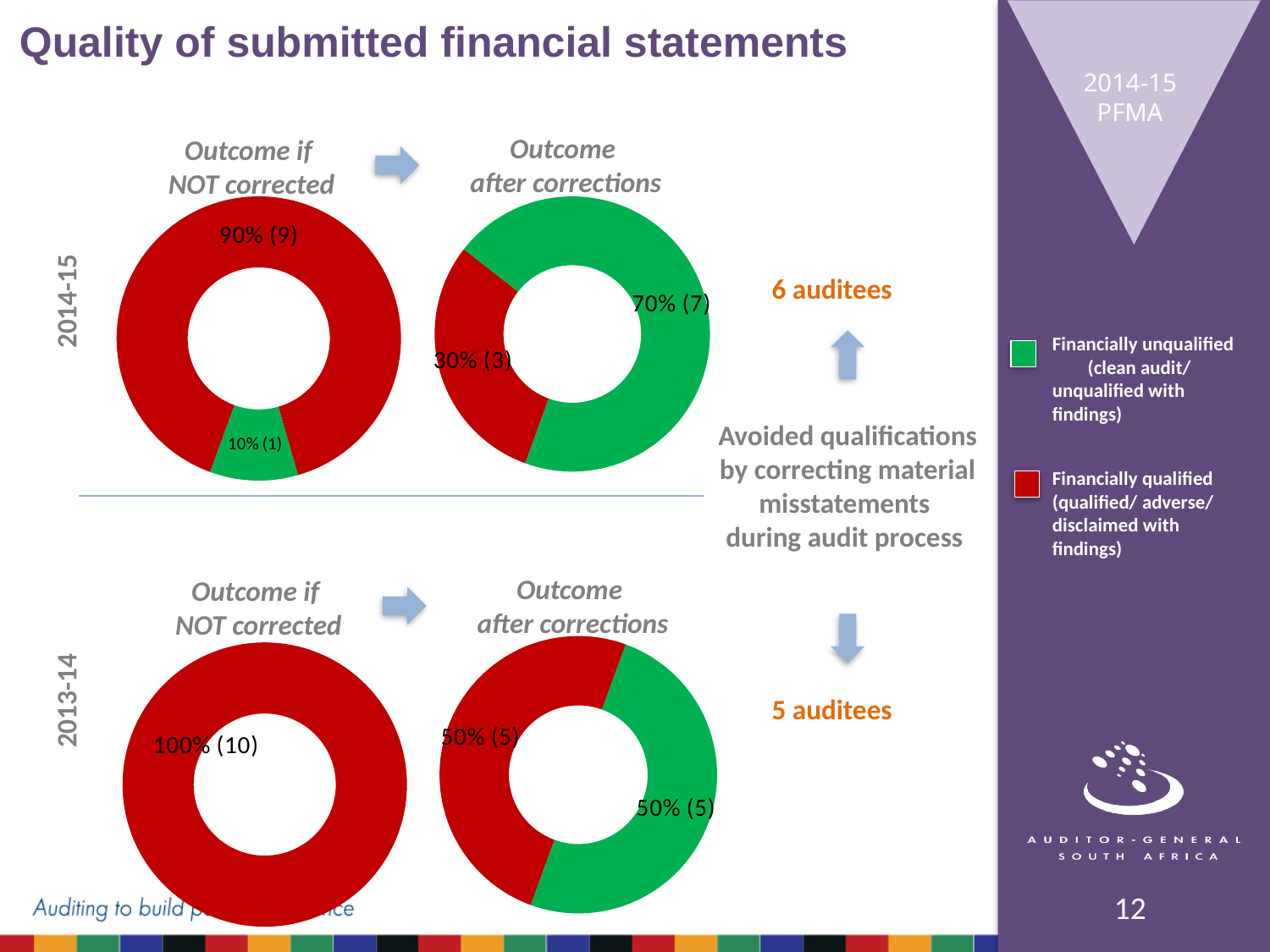
How many segments does the 2013-14 'Outcome if NOT corrected' chart have? 1 According to the legend, what does the green colour represent? Financially unqualified (clean audit/ unqualified with findings) In the 2014-15 'Outcome after corrections' chart, which segment is larger, financially unqualified or financially qualified? Financially unqualified In the 2013-14 'Outcome if NOT corrected' chart, what share is financially qualified (red)? 100% (10) In the 2014-15 'Outcome after corrections' chart, what share is financially qualified (red)? 30% (3) In the 2014-15 'Outcome after corrections' chart, what is the difference in percentage points between the financially unqualified and financially qualified segments? 40 percentage points What type of chart is used to show the outcomes on this slide? Doughnut (pie) chart In the 2014-15 'Outcome after corrections' chart, what share is financially unqualified (green)? 70% (7) In the 2014-15 'Outcome if NOT corrected' chart, what share is financially unqualified (green)? 10% (1) In the 2014-15 'Outcome if NOT corrected' chart, which segment is the smallest? Financially unqualified (10% (1)) In the 2013-14 'Outcome after corrections' chart, what share is financially unqualified (green)? 50% (5) In the 2014-15 'Outcome if NOT corrected' chart, what share is financially qualified (red)? 90% (9)